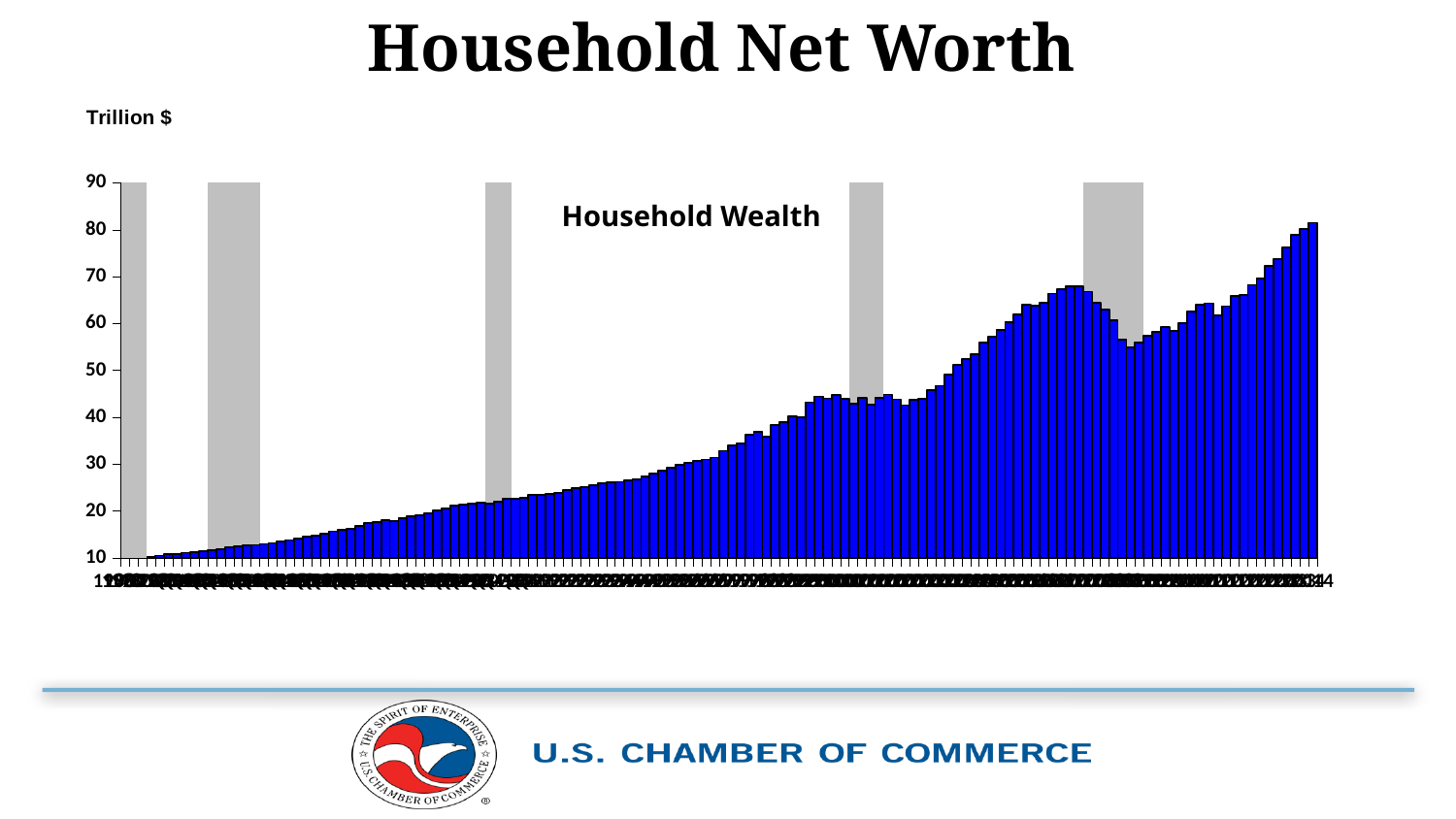
Which is larger, the value of the last bar on the right or the value of the first bar on the left? the last bar on the right Is the value of the peak just before the rightmost gray shaded band greater or less than 60? greater What kind of chart is shown on the slide? bar chart Is the value of the first bar at the left end of the chart greater or less than 20? less Is the value of the last bar at the right end of the chart greater or less than 70? greater In what unit are the values on the vertical axis expressed? Trillion $ Overall, do the values rise or fall from left to right along the x axis? rise